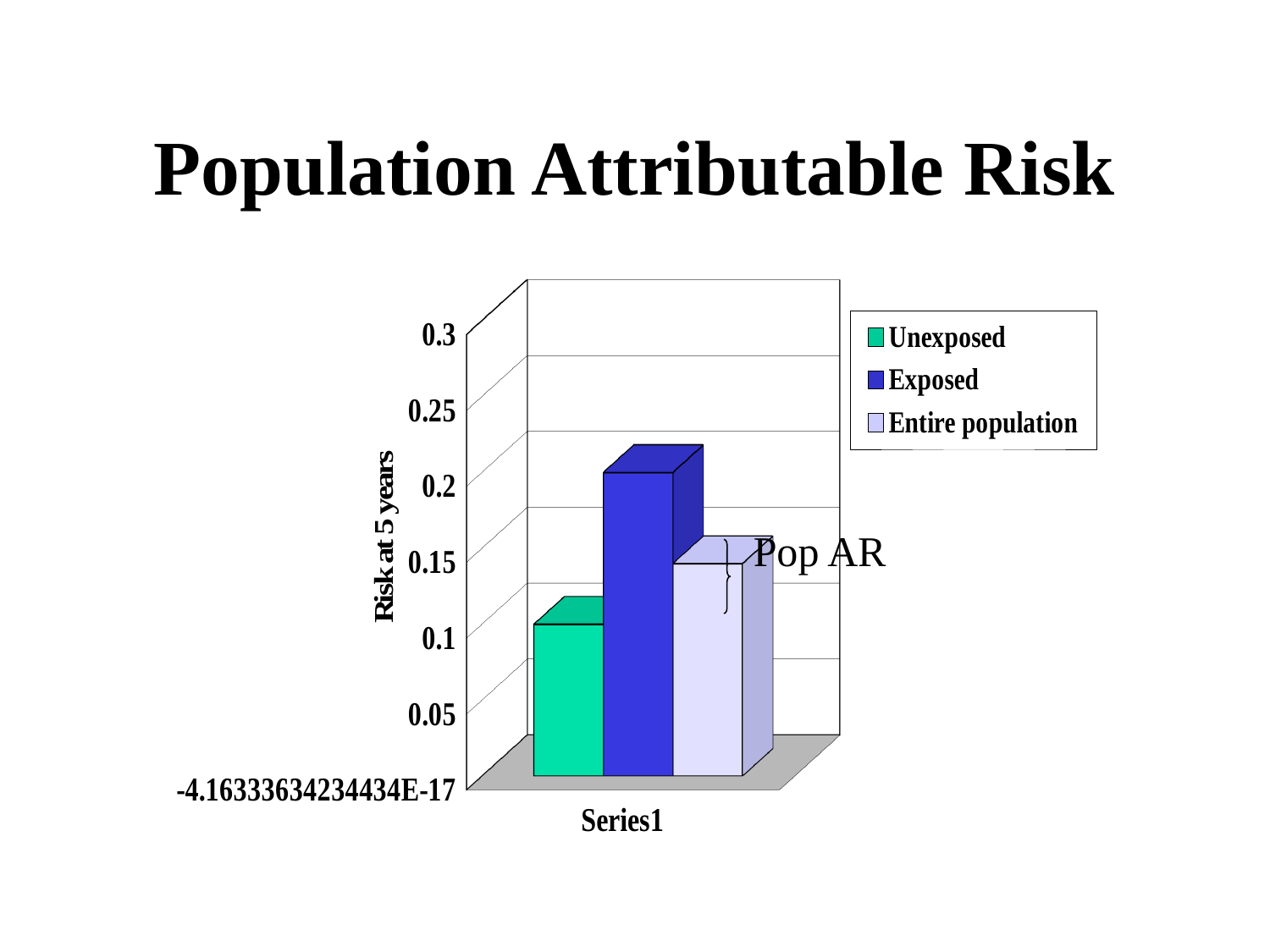
Which series has the highest bar? Exposed How many series does the legend list? 3 What is the title of the vertical axis? Risk at 5 years Is the value for Entire population greater or less than 0.2? less Is the value for Unexposed greater or less than 0.15? less Is the value for Exposed greater or less than 0.25? less Which series has the lowest bar? Unexposed What label appears on the horizontal axis beneath the bars? Series1 Which is larger, the bar for Exposed or the bar for Entire population? Exposed Which is larger, the bar for Unexposed or the bar for Entire population? Entire population What kind of chart is shown on the slide? bar chart